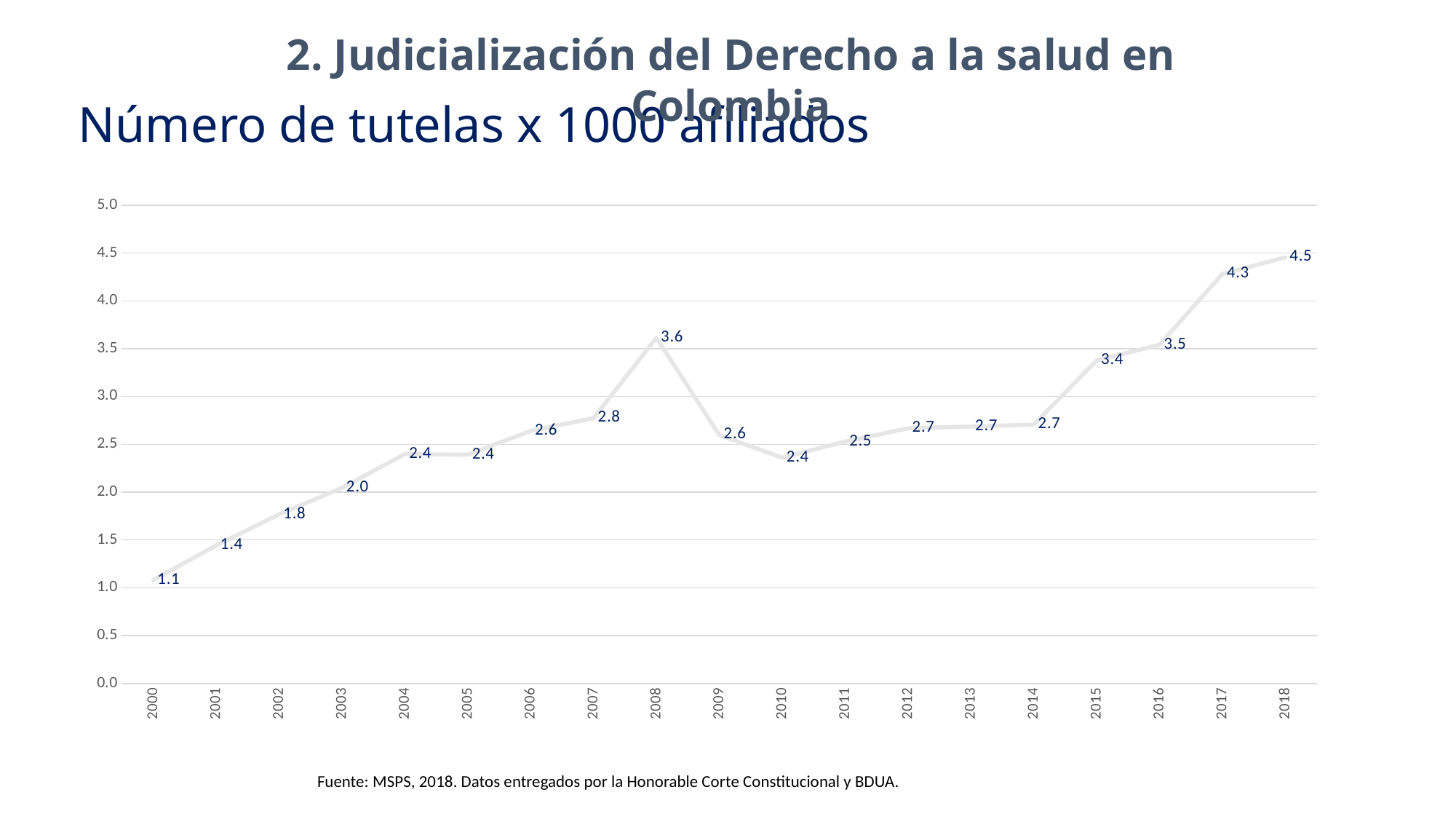
How many years are plotted on the x axis? 19 Which year has the lowest value? 2000 What is the difference between the values for 2018 and 2000? 3.4 What is the value for 2015? 3.4 What is the difference between the values for 2008 and 2009? 1.0 Which is larger, the value for 2008 or the value for 2016? 2008 What kind of chart is shown? line chart What is the value for 2008? 3.6 Do the values rise or fall from 2014 to 2018? rise Is the value for 2017 greater or less than 4.0? greater What is the value for 2000? 1.1 Which year has the highest value? 2018